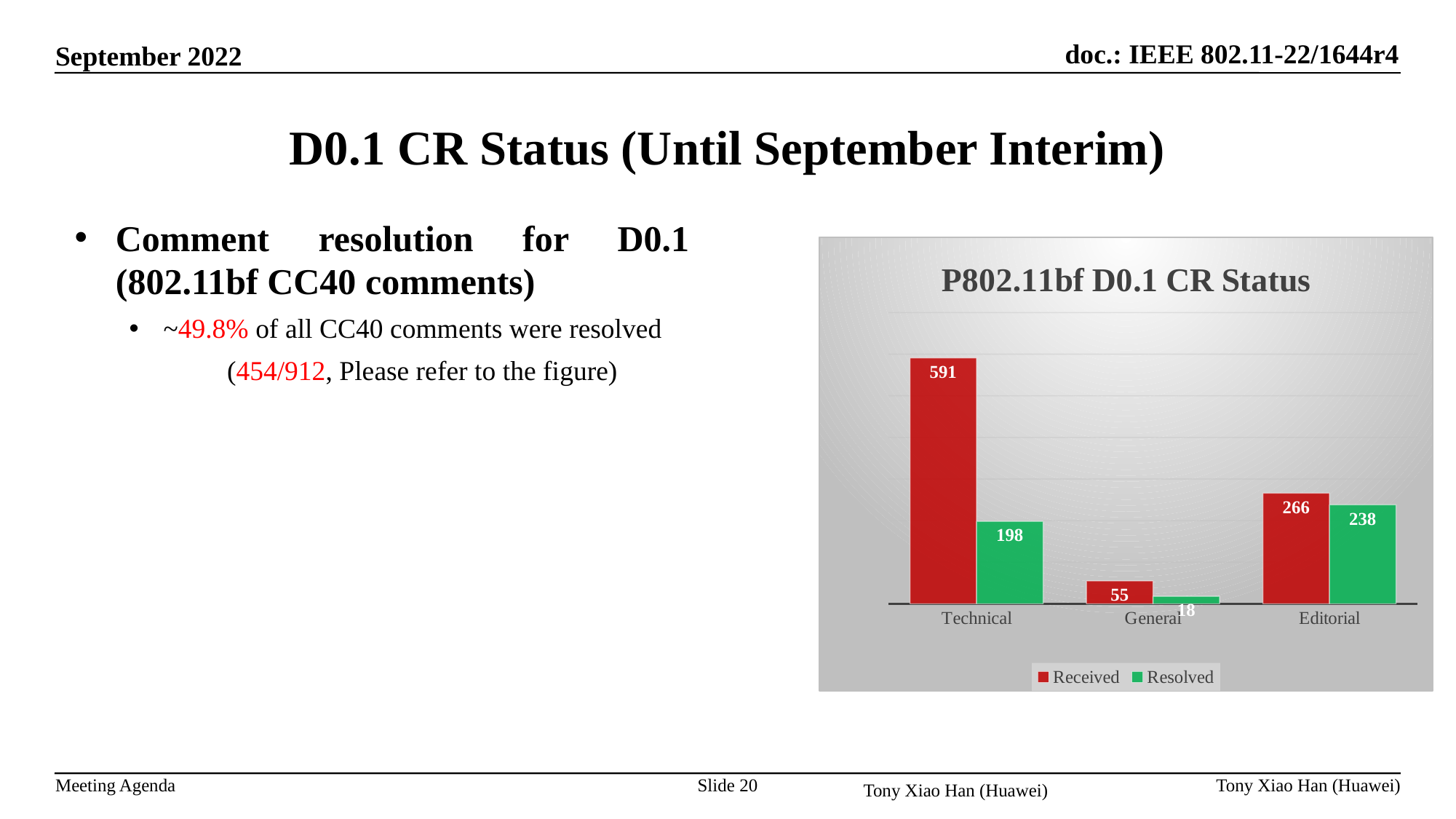
What is the difference between Received and Resolved comments for the Editorial category? 28 How many categories are shown on the x axis of the chart? 3 What is the difference between Received and Resolved comments for the Technical category? 393 Which category has the lowest number of Resolved comments? General What type of chart is shown on the slide? Bar chart What is the number of Resolved comments for the Editorial category? 238 Which category has the highest number of Received comments? Technical What is the number of Resolved comments for the General category? 18 What is the number of Received comments for the Technical category? 591 Which is larger: Resolved comments for Technical or Resolved comments for Editorial? Editorial What is the title of the chart? P802.11bf D0.1 CR Status How many series does the chart legend list? 2